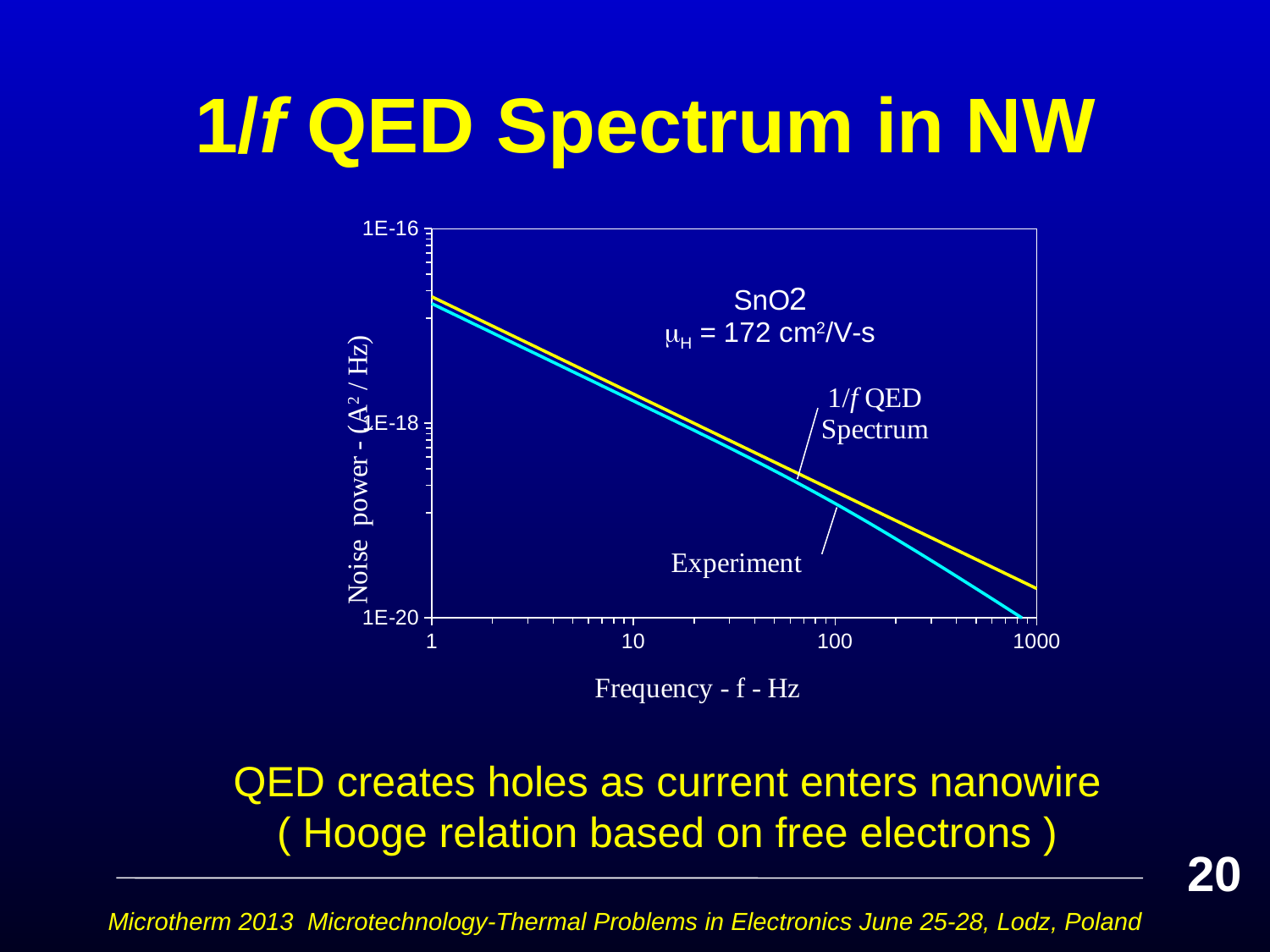
What kind of chart is shown on the slide? line chart At 100 Hz, is the 1/f QED Spectrum value greater or less than 1E-20? greater Do the plotted values rise or fall as frequency increases along the x axis? fall At 1000 Hz, which line is higher: the 1/f QED Spectrum or the Experiment? 1/f QED Spectrum What is the lowest tick value shown on the y axis? 1E-20 What is the highest tick value shown on the x axis? 1000 At 1000 Hz, is the Experiment value greater or less than 1E-18? less What is the label of the x axis of the chart? Frequency - f - Hz At 1 Hz, is the 1/f QED Spectrum value greater or less than 1E-18? greater What material and Hall mobility are annotated on the chart? SnO2, μH = 172 cm²/V-s How many lines are plotted on the chart? 2